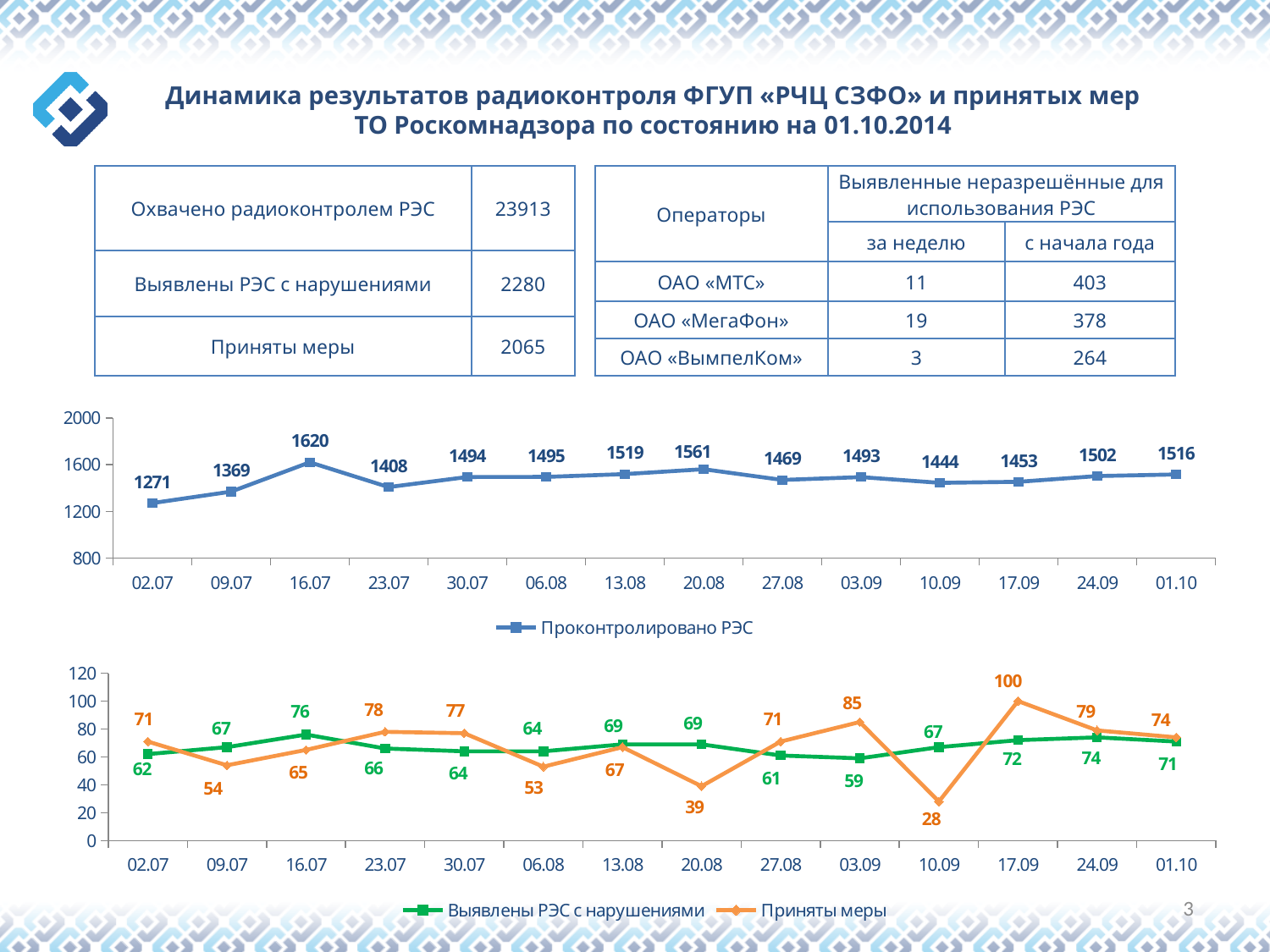
In the bottom chart, what is the value of Приняты меры on 17.09? 100 How many data points are plotted in the top chart? 14 In the top chart, what is the value of Проконтролировано РЭС on 16.07? 1620 In the bottom chart, what is the value of Выявлены РЭС с нарушениями on 16.07? 76 What type of chart is the bottom chart? line chart In the bottom chart, what is the difference between Приняты меры and Выявлены РЭС с нарушениями on 03.09? 26 In the top chart, what is the difference between the values on 01.10 and 02.07? 245 How many series does the legend of the bottom chart list? 2 In the bottom chart, on which date is Приняты меры lowest? 10.09 In the top chart, on which date is Проконтролировано РЭС highest? 16.07 In the top chart, on which date is Проконтролировано РЭС lowest? 02.07 In the bottom chart, which is larger on 20.08: Выявлены РЭС с нарушениями or Приняты меры? Выявлены РЭС с нарушениями